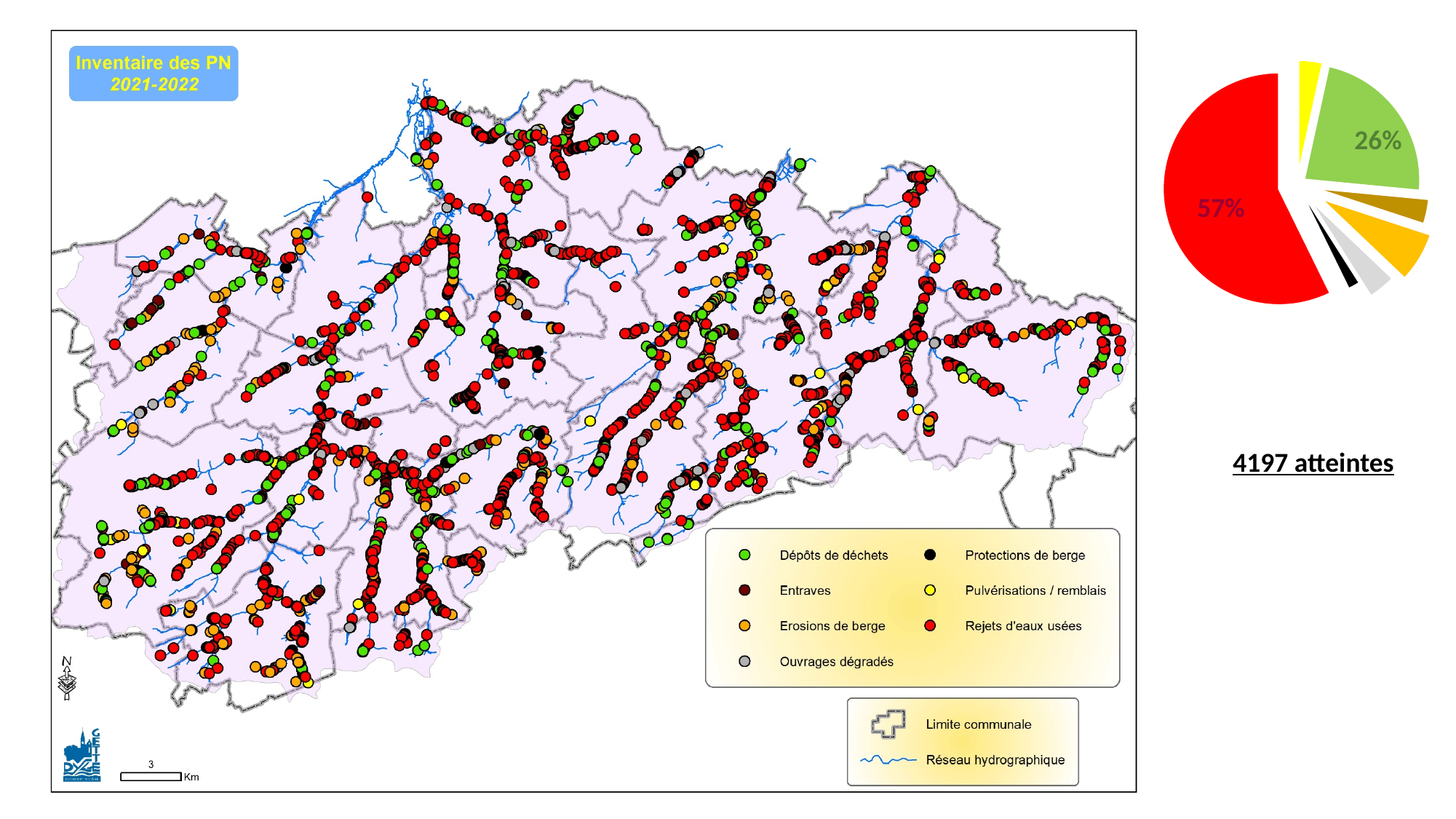
What total number of 'atteintes' is written below the pie chart? 4197 atteintes Which colour slice is the largest in the pie chart? red In the pie chart, what percentage is shown on the green slice? 26% In the pie chart, is the red slice larger or smaller than the green slice? larger In the pie chart, what percentage is shown on the red slice? 57% Is the red slice of the pie chart greater or less than 50%? greater What is the difference between the percentages printed on the red and green slices of the pie chart? 31% Which colour slice is the smallest in the pie chart? black How many slices does the pie chart have? 7 According to the map legend, which category is represented by red dots? Rejets d'eaux usées What kind of chart is shown on the right side of the slide? pie chart